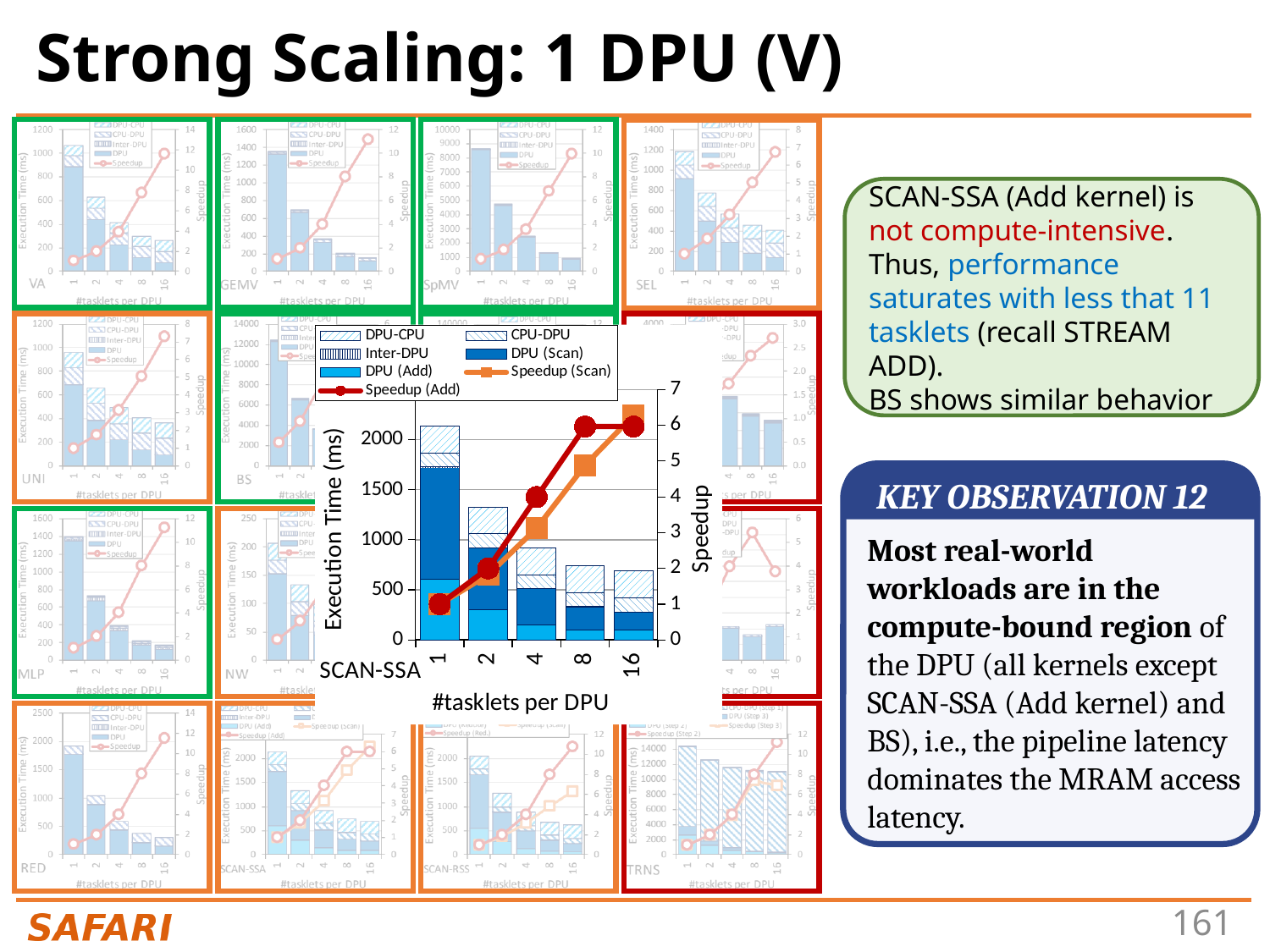
On the enlarged SCAN-SSA chart, what is the label of the left y axis? Execution Time (ms) On the enlarged SCAN-SSA chart, is the total execution time for 16 tasklets per DPU greater or less than 1000 ms? less On the enlarged SCAN-SSA chart, how many series does the legend list? 7 On the enlarged SCAN-SSA chart, what kind of chart is used for the execution time data? bar chart On the enlarged SCAN-SSA chart, does the total execution time rise or fall as the number of tasklets per DPU increases? fall On the enlarged SCAN-SSA chart, how many tasklet counts are shown on the x axis? 5 On the enlarged SCAN-SSA chart, which number of tasklets per DPU has the highest Speedup (Scan) value? 16 On the enlarged SCAN-SSA chart, is the Speedup (Add) value at 4 tasklets per DPU greater or less than 3? greater On the enlarged SCAN-SSA chart, which number of tasklets per DPU has the highest total execution time? 1 On the enlarged SCAN-SSA chart, is the total execution time for 1 tasklet per DPU greater or less than 2000 ms? greater On the enlarged SCAN-SSA chart, what is the label of the x axis? #tasklets per DPU